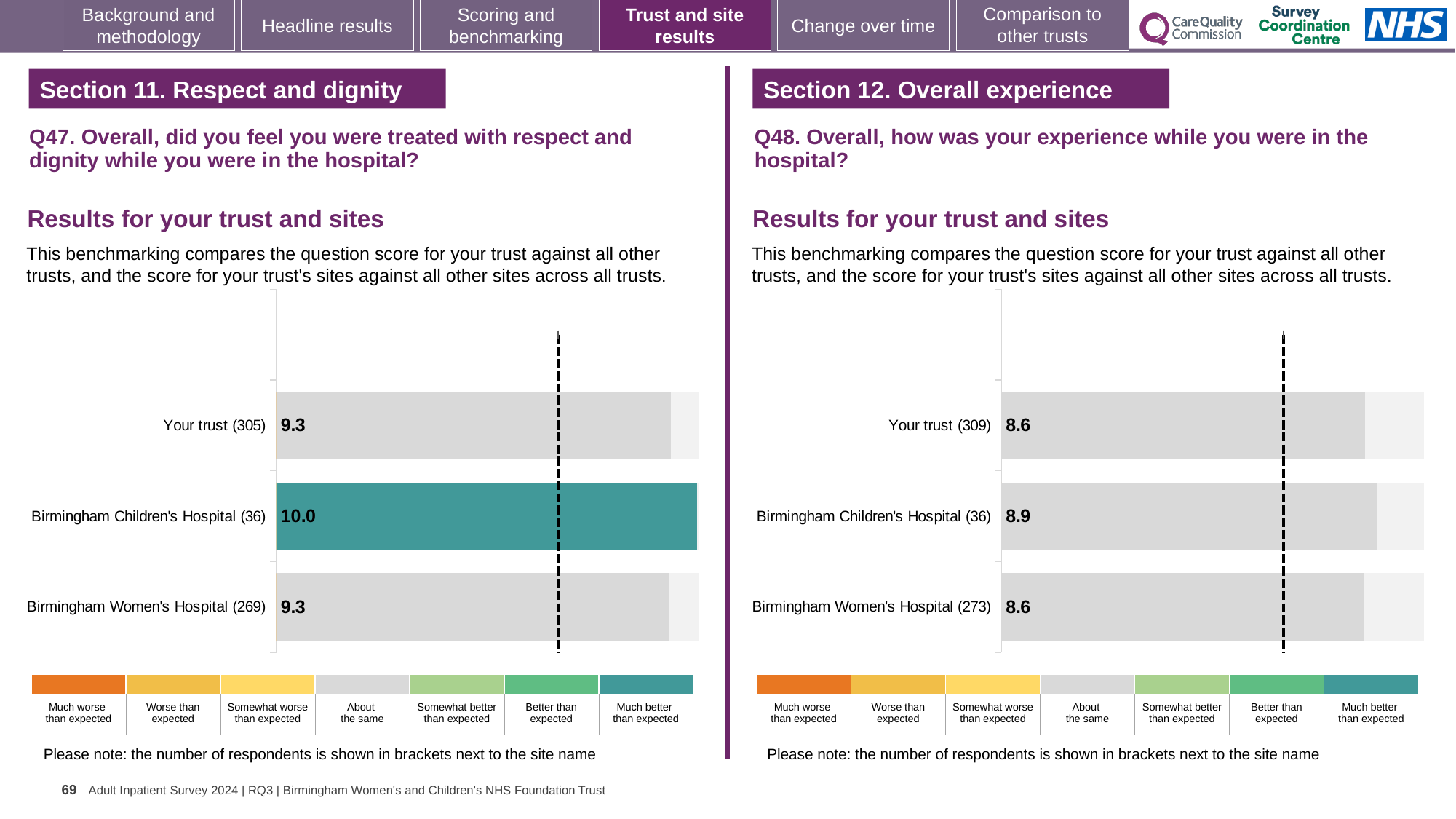
How many bars are plotted in the Q47 chart on the left? 3 In the Q47 chart on the left, what is the score for Your trust? 9.3 In the Q48 chart on the right, how many respondents are shown in brackets for Birmingham Women's Hospital? 273 In the Q48 chart on the right, which site has the highest score? Birmingham Children's Hospital In the Q47 chart on the left, what is the score for Birmingham Children's Hospital? 10.0 In the Q48 chart on the right, what is the difference between the score for Birmingham Children's Hospital and the score for Your trust? 0.3 In the Q48 chart on the right, what is the score for Birmingham Women's Hospital? 8.6 In the Q47 chart on the left, what is the difference between the score for Birmingham Children's Hospital and the score for Birmingham Women's Hospital? 0.7 In the Q48 chart on the right, which has the larger score: Birmingham Children's Hospital or Birmingham Women's Hospital? Birmingham Children's Hospital What type of chart is used for the Q48 results on the right? Bar chart In the Q47 chart on the left, which site has the highest score? Birmingham Children's Hospital In the Q48 chart on the right, what is the score for Birmingham Children's Hospital? 8.9